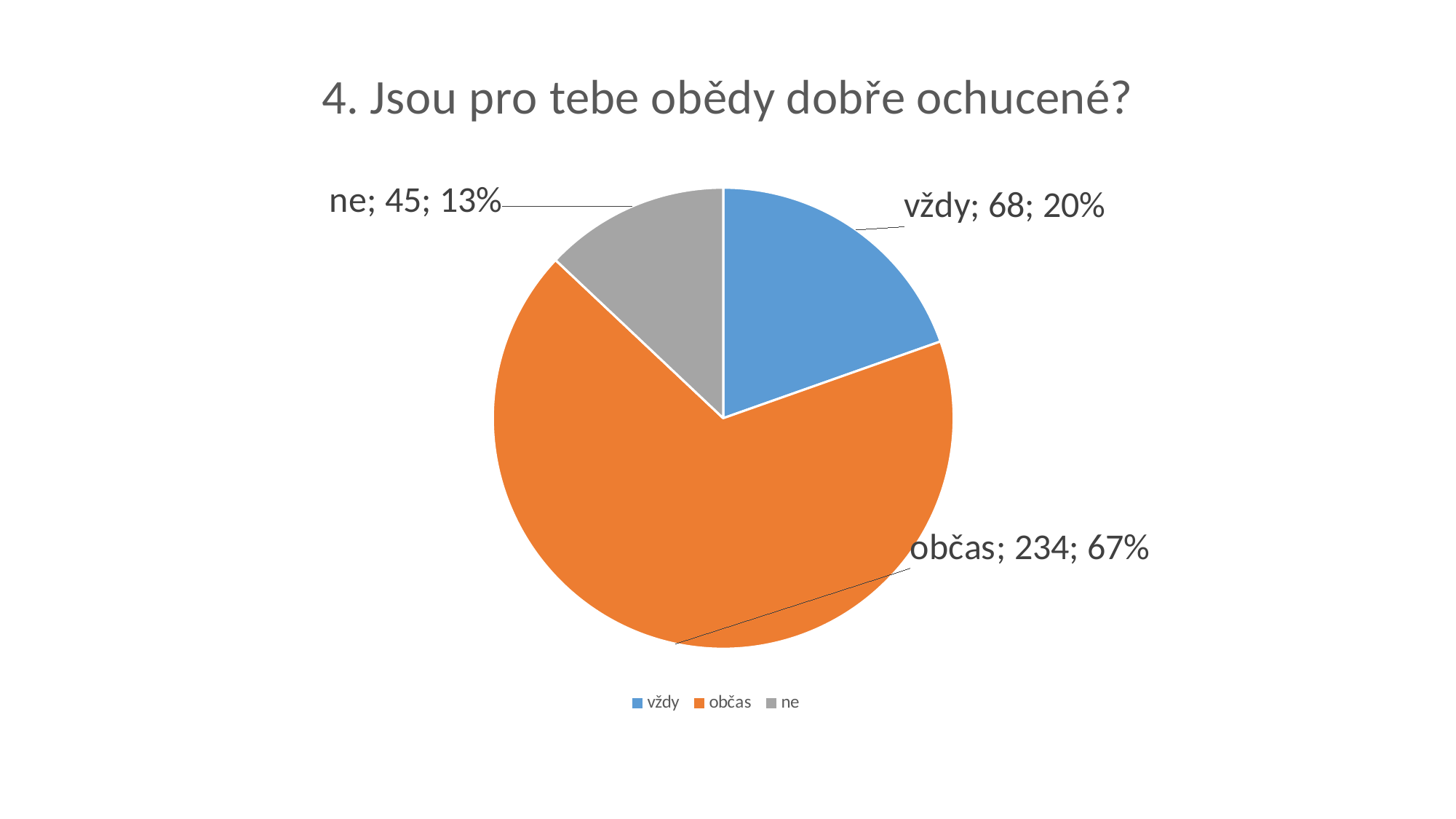
How many entries does the legend list? 3 What is the difference between the counts for 'občas' and 'vždy'? 166 What share of the pie does 'ne' represent? 13% What share of the pie does 'občas' represent? 67% What is the count for 'ne'? 45 What is the title of the chart? 4. Jsou pro tebe obědy dobře ochucené? Which category has the smallest slice? ne How many slices does the pie chart have? 3 Which category has the largest slice? občas What is the count for 'vždy'? 68 What is the count for 'občas'? 234 What kind of chart is shown on the slide? pie chart